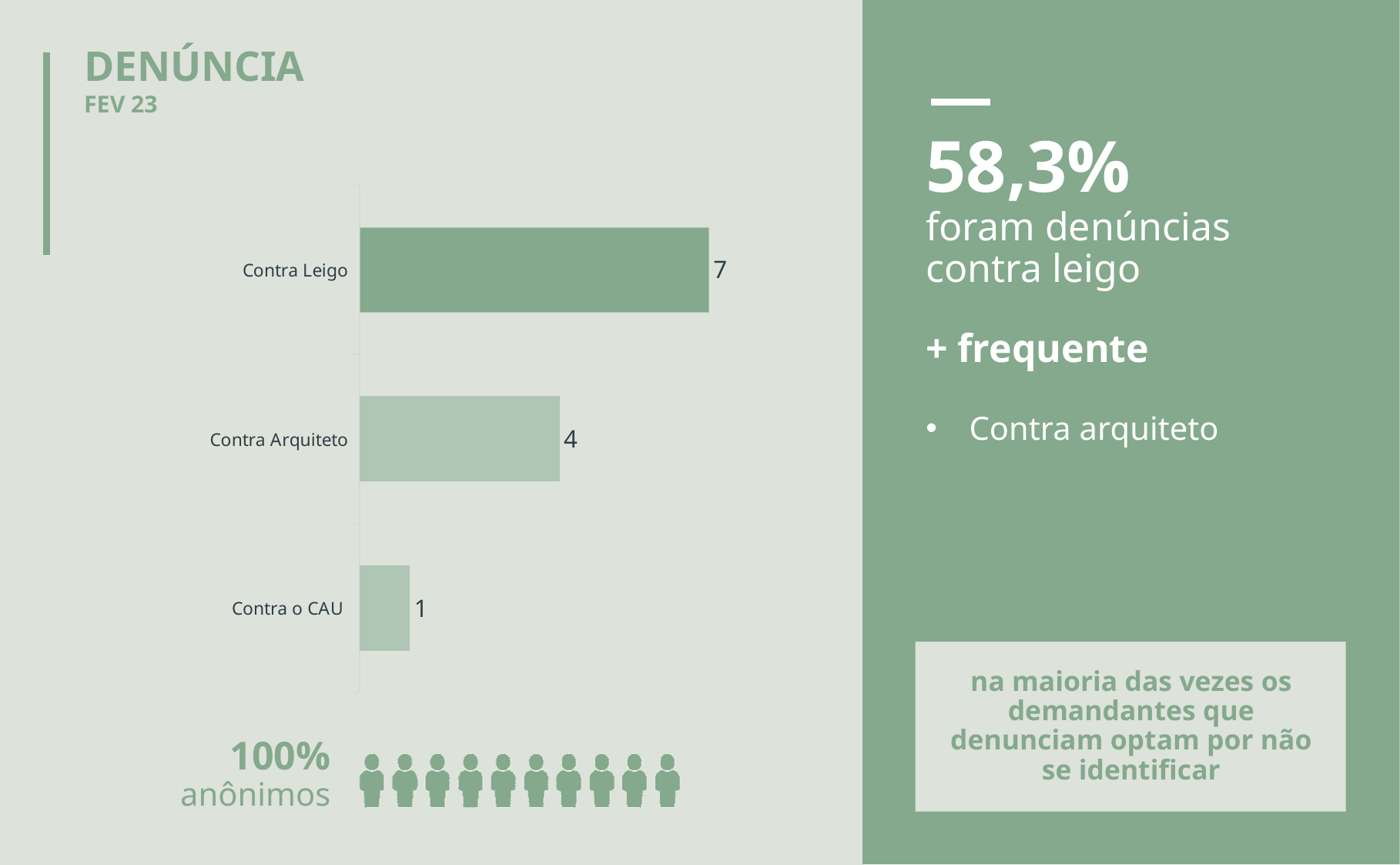
What is the value for Contra o CAU? 1 What is the value for Contra Arquiteto? 4 What is the total of the three values shown in the chart? 12 What is the value for Contra Leigo? 7 What kind of chart is shown on the slide? bar chart Which category has the highest value? Contra Leigo Which category has the lowest value? Contra o CAU Which is larger, the value for Contra Arquiteto or the value for Contra o CAU? Contra Arquiteto How many categories are shown in the chart? 3 What is the difference between the values for Contra Leigo and Contra Arquiteto? 3 What is the title shown above the chart? DENÚNCIA What is the difference between the values for Contra Arquiteto and Contra o CAU? 3